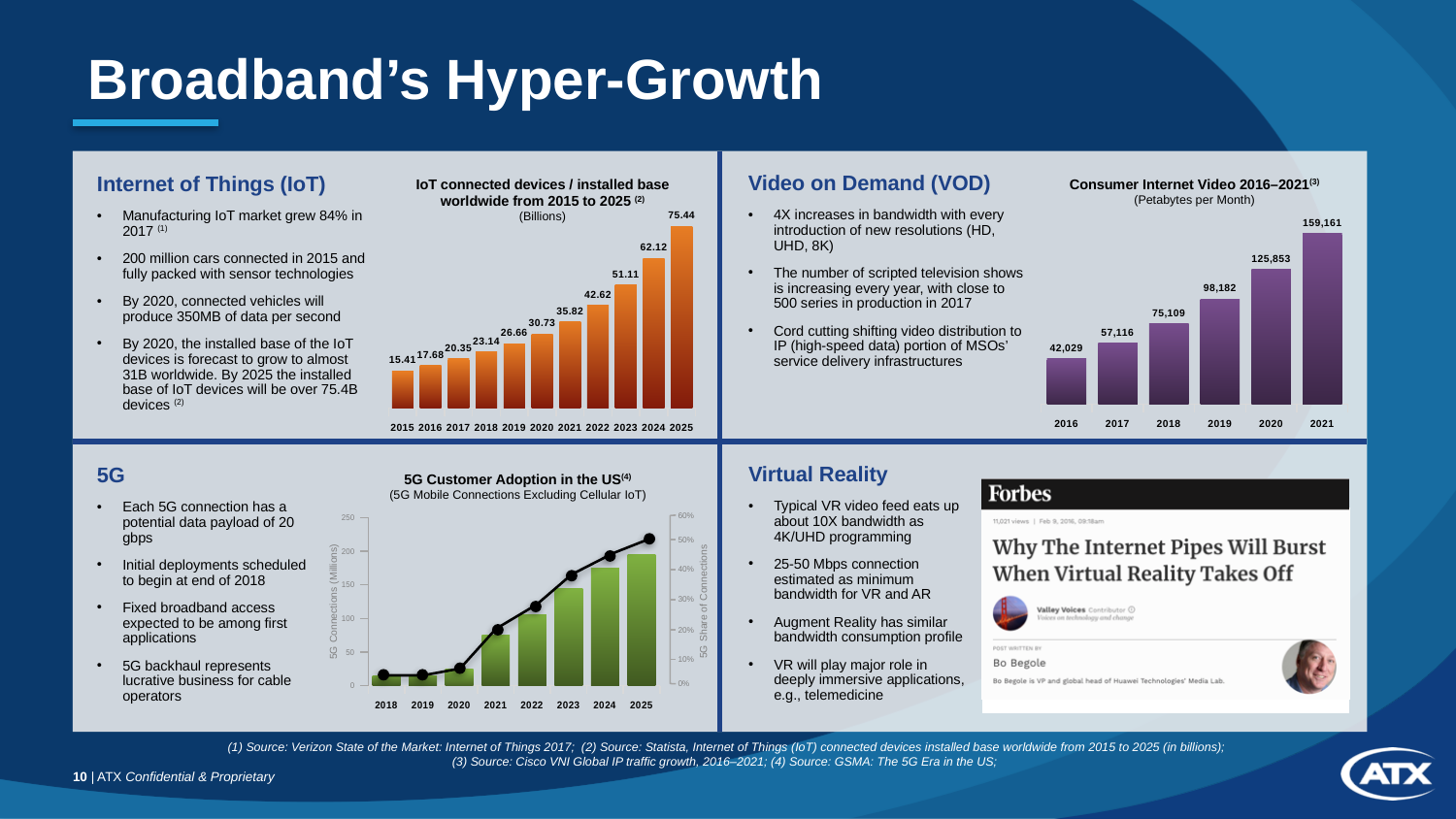
In the 'IoT connected devices / installed base worldwide from 2015 to 2025' chart, what is the difference between the 2025 and 2024 values? 13.32 In the 'Consumer Internet Video 2016–2021' chart, which year has the highest value? 2021 In the 'Consumer Internet Video 2016–2021' chart, what is the difference between the 2021 and 2016 values? 117,132 In the 'IoT connected devices / installed base worldwide from 2015 to 2025' chart, what is the value for 2020? 30.73 In the 'IoT connected devices / installed base worldwide from 2015 to 2025' chart, what is the value for 2025? 75.44 In the 'IoT connected devices / installed base worldwide from 2015 to 2025' chart, how many years are plotted? 11 In the 'IoT connected devices / installed base worldwide from 2015 to 2025' chart, do the values rise or fall from 2015 to 2025? rise In the 'IoT connected devices / installed base worldwide from 2015 to 2025' chart, which year has the lowest value? 2015 In the 'Consumer Internet Video 2016–2021' chart, what unit is given in the subtitle? Petabytes per Month In the 'Consumer Internet Video 2016–2021' chart, what is the value for 2019? 98,182 In the '5G Customer Adoption in the US' chart, is the bar value for 2025 greater or less than 150 on the left axis? greater In the '5G Customer Adoption in the US' chart, is the bar value for 2021 greater or less than 100 on the left axis? less